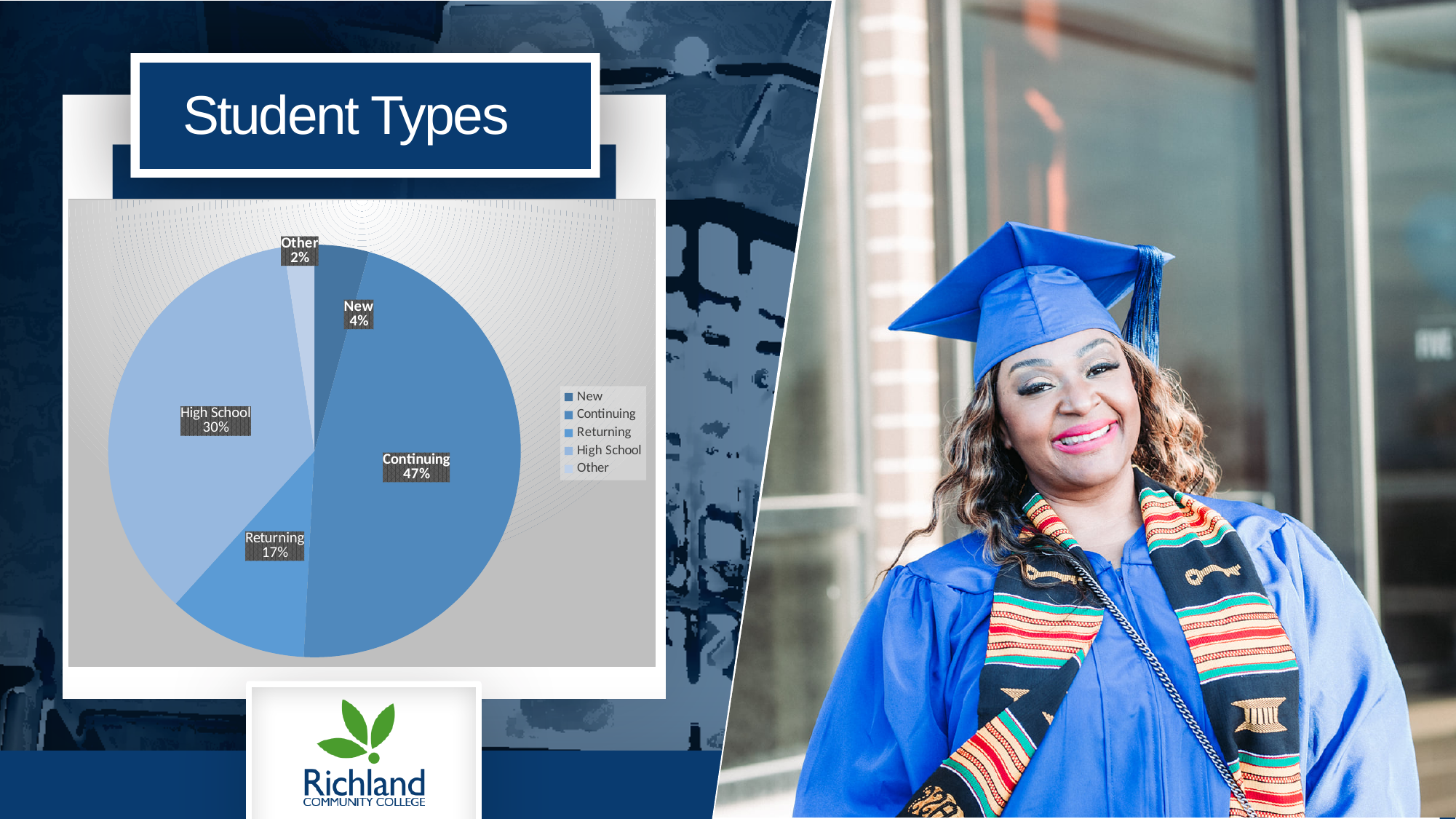
What percentage of students are Returning students? 17% Which student type has the smallest share of the pie? Other Which is larger: the Returning share or the New share? Returning Which student type has the largest share of the pie? Continuing How many student types are shown in the pie chart? 5 What percentage of students are New students? 4% What percentage of students are Continuing students? 47% What type of chart is shown on the slide? pie chart What percentage of students fall under Other? 2% How many percentage points larger is the Continuing share than the High School share? 17 What percentage of students are High School students? 30% What is the title of the chart? Student Types